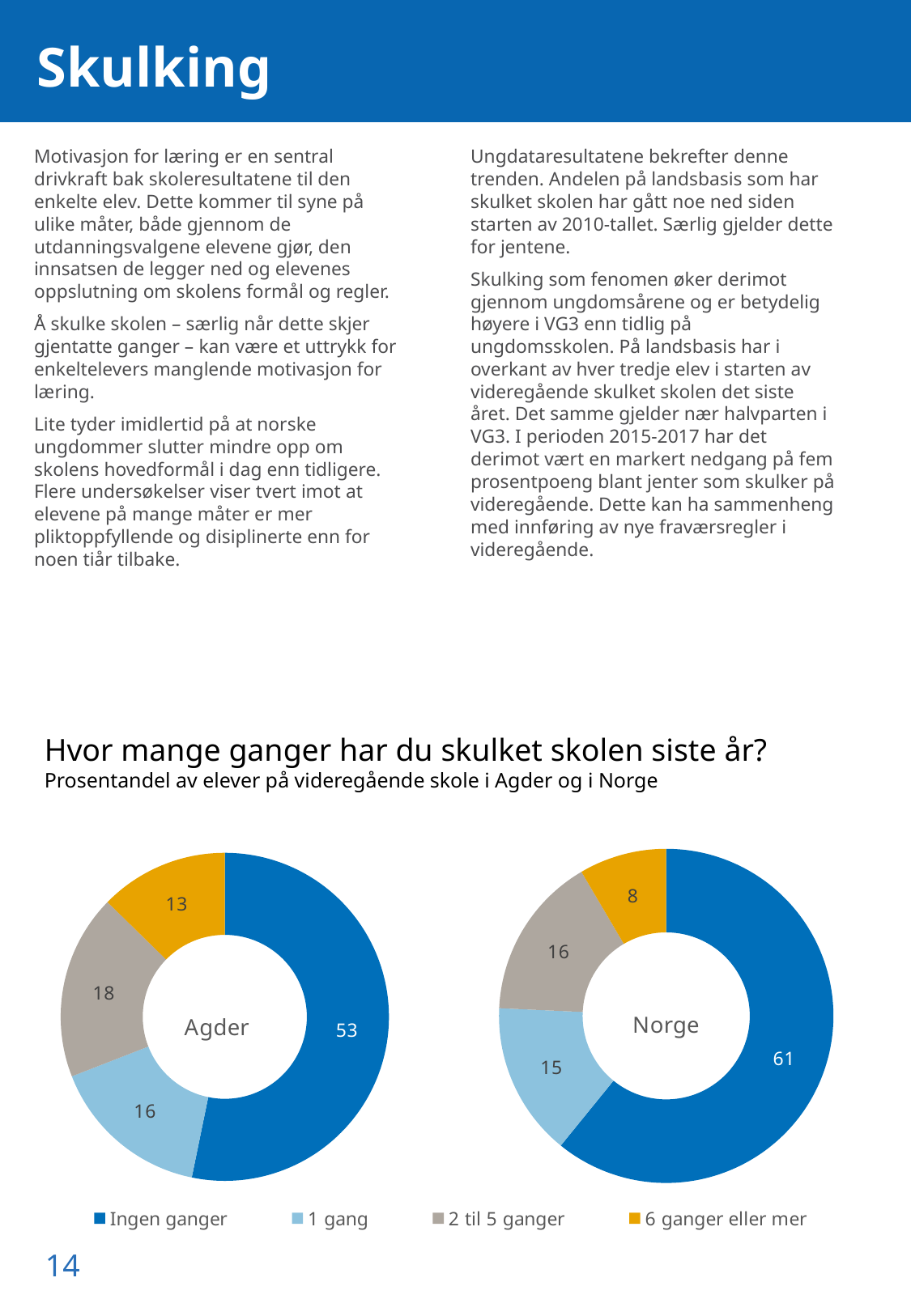
In the Norge chart, which category has the smallest slice? 6 ganger eller mer What kind of chart is used for Agder and Norge? Pie (donut) chart In the Agder chart, which category has the largest slice? Ingen ganger Which is larger: '6 ganger eller mer' in the Agder chart or '6 ganger eller mer' in the Norge chart? Agder In the Norge chart, what is the value for '1 gang'? 15 How many entries does the legend list? 4 In the Norge chart, what is the value for '6 ganger eller mer'? 8 How many categories does each donut chart show? 4 What is the difference between the 'Ingen ganger' value in the Norge chart and the 'Ingen ganger' value in the Agder chart? 8 What is the title of the chart section on the slide? Hvor mange ganger har du skulket skolen siste år? In the Agder chart, what is the value for 'Ingen ganger'? 53 In the Agder chart, what is the value for '2 til 5 ganger'? 18